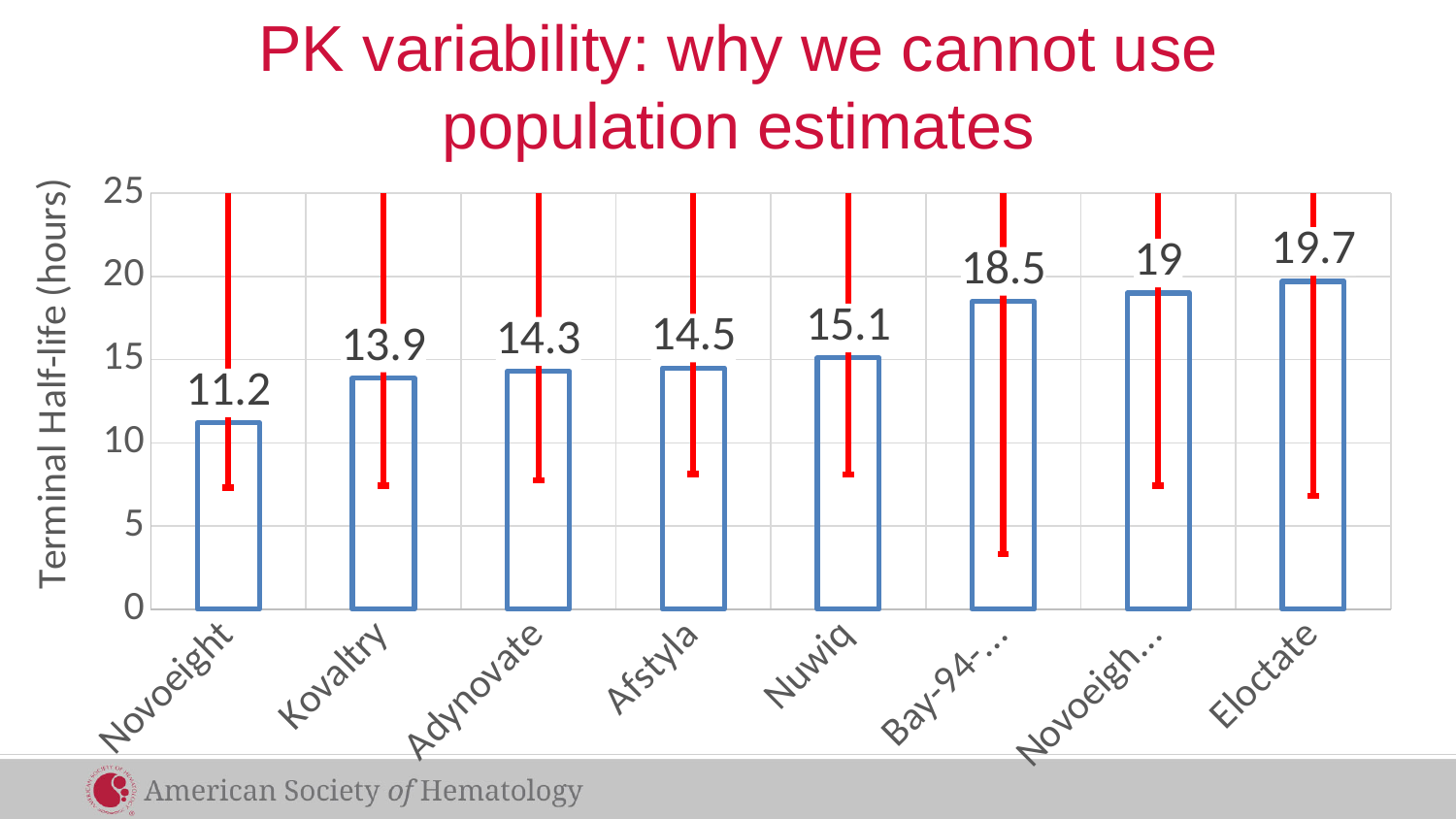
Which product has the lowest terminal half-life in the chart? Novoeight What is the value shown for Afstyla? 14.5 How many bars are plotted in the chart? 8 What is the value shown for Kovaltry? 13.9 What is the difference between the values for Eloctate and Novoeight (the first bar)? 8.5 What is the label of the vertical axis? Terminal Half-life (hours) What is the terminal half-life value shown for Novoeight (the first bar)? 11.2 What is the value shown for Nuwiq? 15.1 What is the value shown for Adynovate? 14.3 Which has a larger value, Nuwiq or Kovaltry? Nuwiq What is the value shown for Eloctate? 19.7 Which product has the highest terminal half-life in the chart? Eloctate